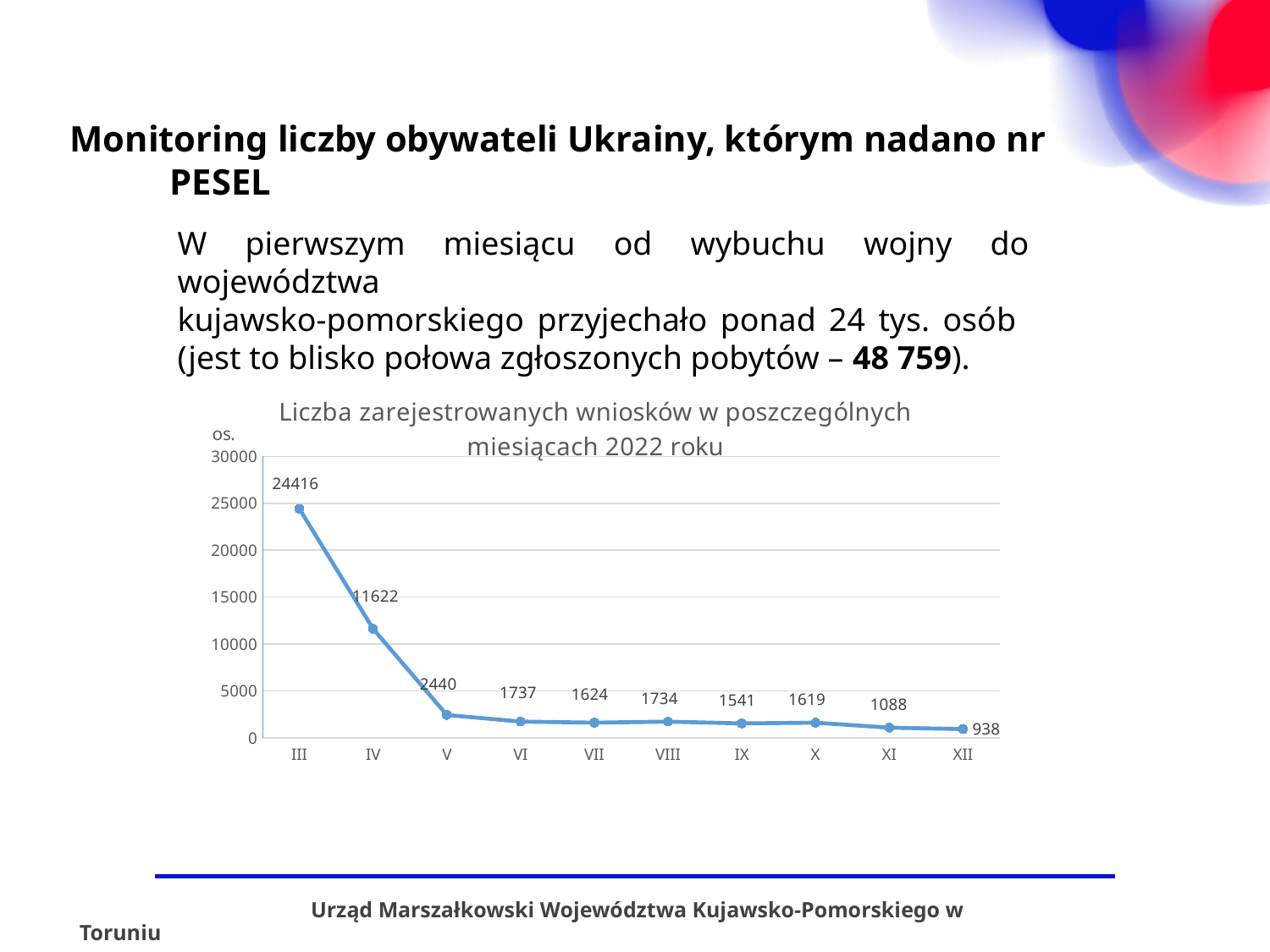
What is the difference between the values for months III and IV? 12794 Which month has the highest value? III Which is larger, the value for month VI or month VII? VI What kind of chart is shown? line chart Do the values rise or fall from month III to month XII? fall What is the value for month III? 24416 What is the value for month VIII? 1734 What is the title of the chart? Liczba zarejestrowanych wniosków w poszczególnych miesiącach 2022 roku How many months are plotted on the chart? 10 Is the value for month IV greater or less than 10000? greater What is the value for month XII? 938 Which month has the lowest value? XII